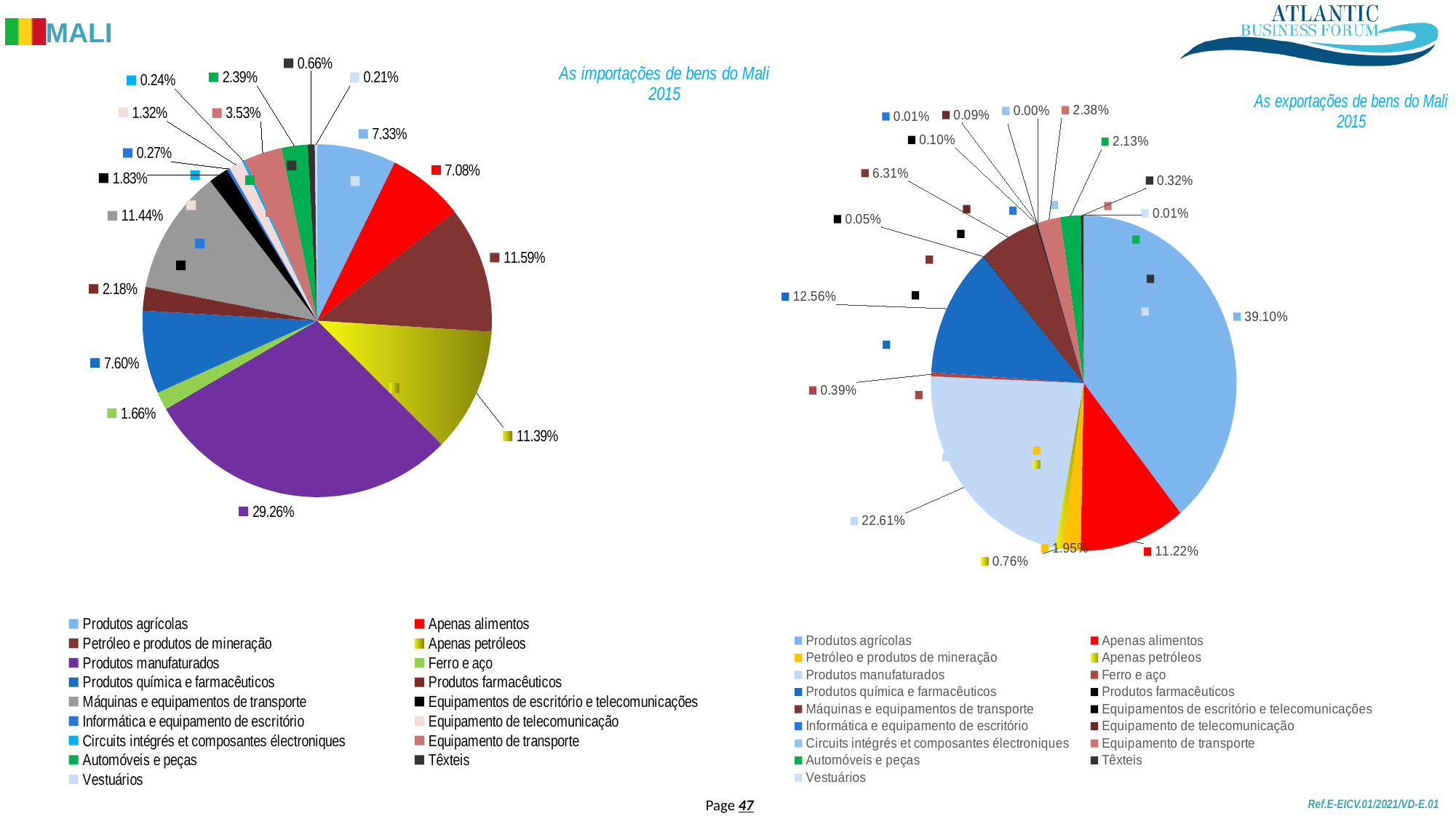
In the 'As exportações de bens do Mali 2015' pie chart, which is larger: Apenas alimentos or Máquinas e equipamentos de transporte? Apenas alimentos How many categories does the legend of the 'As exportações de bens do Mali 2015' chart list? 17 In the 'As importações de bens do Mali 2015' pie chart, what share is shown for Máquinas e equipamentos de transporte? 11.44% In the 'As exportações de bens do Mali 2015' pie chart, what is the difference between the shares of Produtos agrícolas and Produtos manufaturados? 16.49% In the 'As importações de bens do Mali 2015' pie chart, which is larger: Apenas alimentos or Produtos agrícolas? Produtos agrícolas What type of chart is used for 'As importações de bens do Mali 2015'? Pie chart In the 'As exportações de bens do Mali 2015' pie chart, which category has the largest slice? Produtos agrícolas In the 'As importações de bens do Mali 2015' pie chart, which category has the largest slice? Produtos manufaturados In the 'As importações de bens do Mali 2015' pie chart, what is the difference between the shares of Petróleo e produtos de mineração and Apenas petróleos? 0.20% In the 'As importações de bens do Mali 2015' pie chart, what share is shown for Produtos manufaturados? 29.26% In the 'As exportações de bens do Mali 2015' pie chart, what share is shown for Produtos química e farmacêuticos? 12.56% In the 'As exportações de bens do Mali 2015' pie chart, what share is shown for Produtos agrícolas? 39.10%